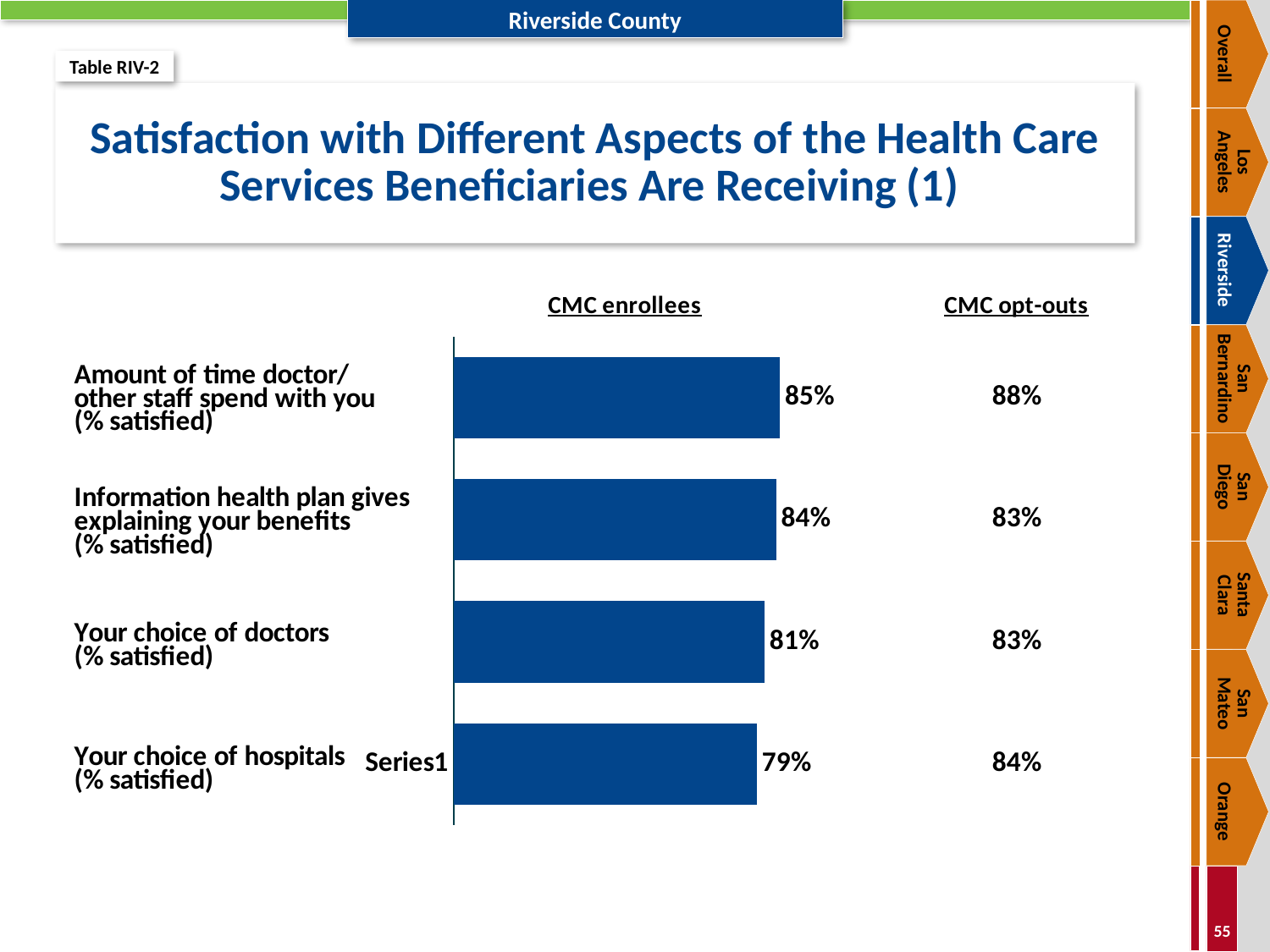
How many aspects of health care services are shown as bars in the chart? 4 What percentage of CMC enrollees are satisfied with their choice of doctors? 81% Do the CMC enrollees values rise or fall going from the top bar to the bottom bar? Fall Among CMC enrollees, which has the larger satisfaction value: 'Your choice of doctors' or 'Your choice of hospitals'? Your choice of doctors Which aspect has the highest satisfaction among CMC enrollees? Amount of time doctor/other staff spend with you What kind of chart is shown on the slide? Bar chart What is the CMC enrollees value for 'Your choice of hospitals'? 79% What is the column heading above the bars in the chart? CMC enrollees What is the CMC enrollees value for 'Information health plan gives explaining your benefits'? 84% What is the difference between the CMC enrollees values for 'Amount of time doctor/other staff spend with you' and 'Your choice of hospitals'? 6 percentage points What percentage of CMC enrollees are satisfied with the amount of time doctor/other staff spend with them? 85% Which aspect has the lowest satisfaction among CMC enrollees? Your choice of hospitals